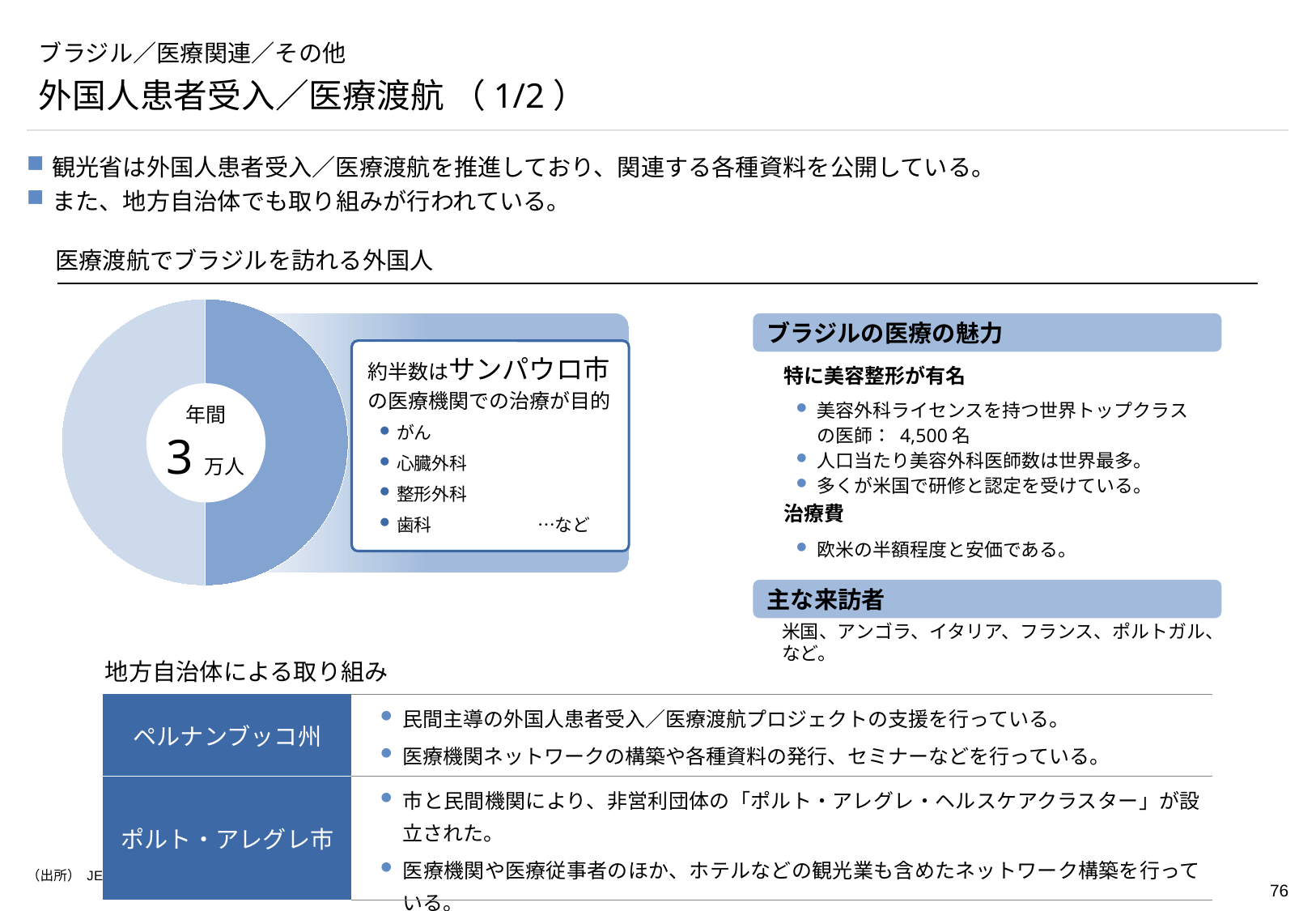
「医療渡航でブラジルを訪れる外国人」のグラフはどの種類のグラフですか？ 円グラフ（ドーナツ型） 「医療渡航でブラジルを訪れる外国人」のグラフはいくつの部分に分かれていますか？ 2 「医療渡航でブラジルを訪れる外国人」のグラフの中央に示されている年間の人数はいくらですか？ 3万人 スライド左側の円グラフの見出し（タイトル）は何ですか？ 医療渡航でブラジルを訪れる外国人 「医療渡航でブラジルを訪れる外国人」のグラフで、濃い青色の部分は何を表していますか？ サンパウロ市の医療機関での治療が目的の人 「医療渡航でブラジルを訪れる外国人」のグラフで、サンパウロ市の医療機関での治療が目的の人はどのくらいの割合と示されていますか？ 約半数